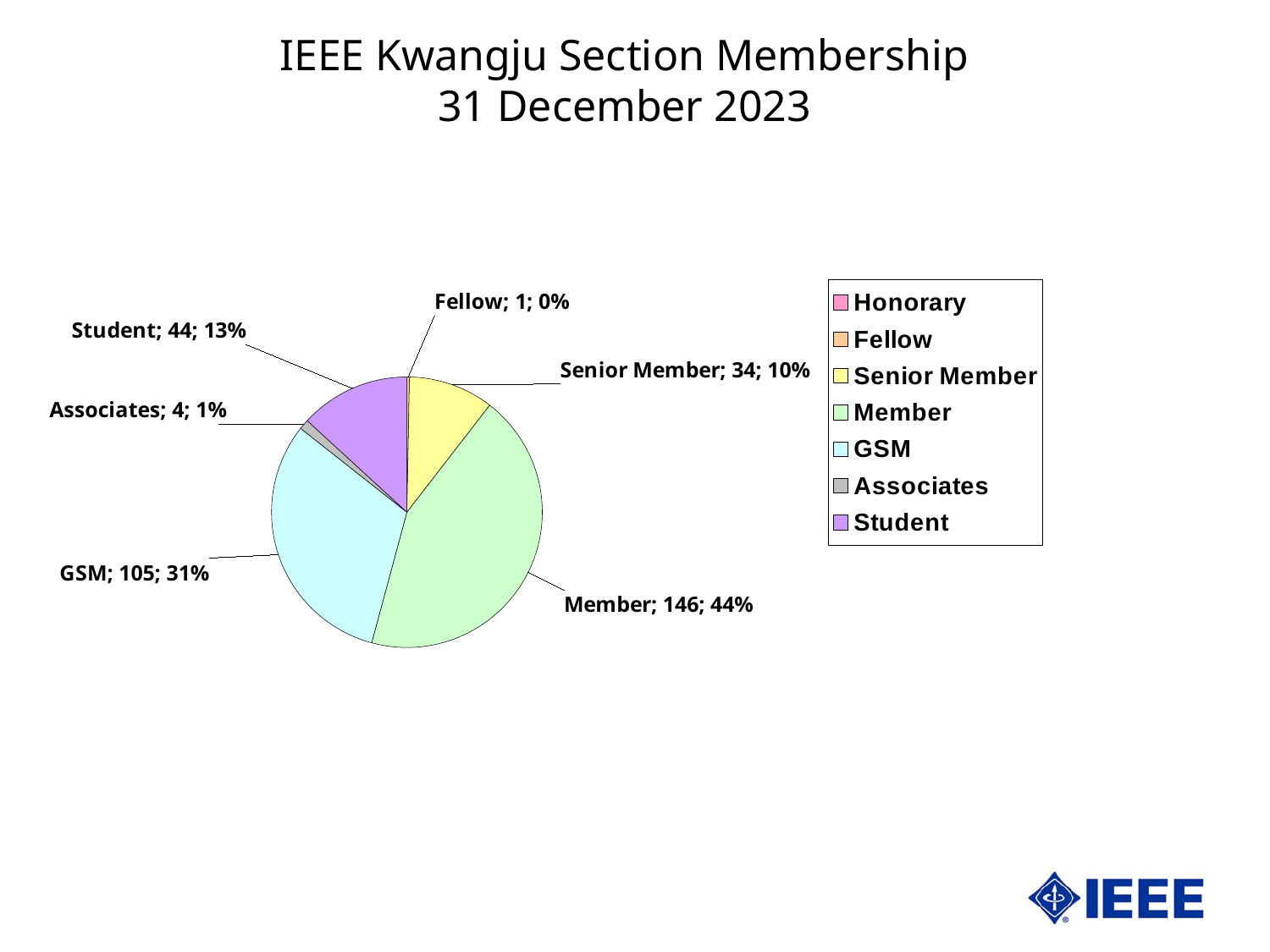
Which is larger, the Student count or the Senior Member count? Student What type of chart is shown on the slide? Pie chart How many members are in the Member category? 146 What share of the pie does GSM represent? 31% How many members are in the Associates category? 4 What is the difference between the Member count and the GSM count? 41 How many entries does the legend list? 7 Which category has the largest slice of the pie? Member What is the title of the chart? IEEE Kwangju Section Membership 31 December 2023 How many members are in the Senior Member category? 34 What percentage of the membership is Student? 13% Which labelled category has the smallest count? Fellow